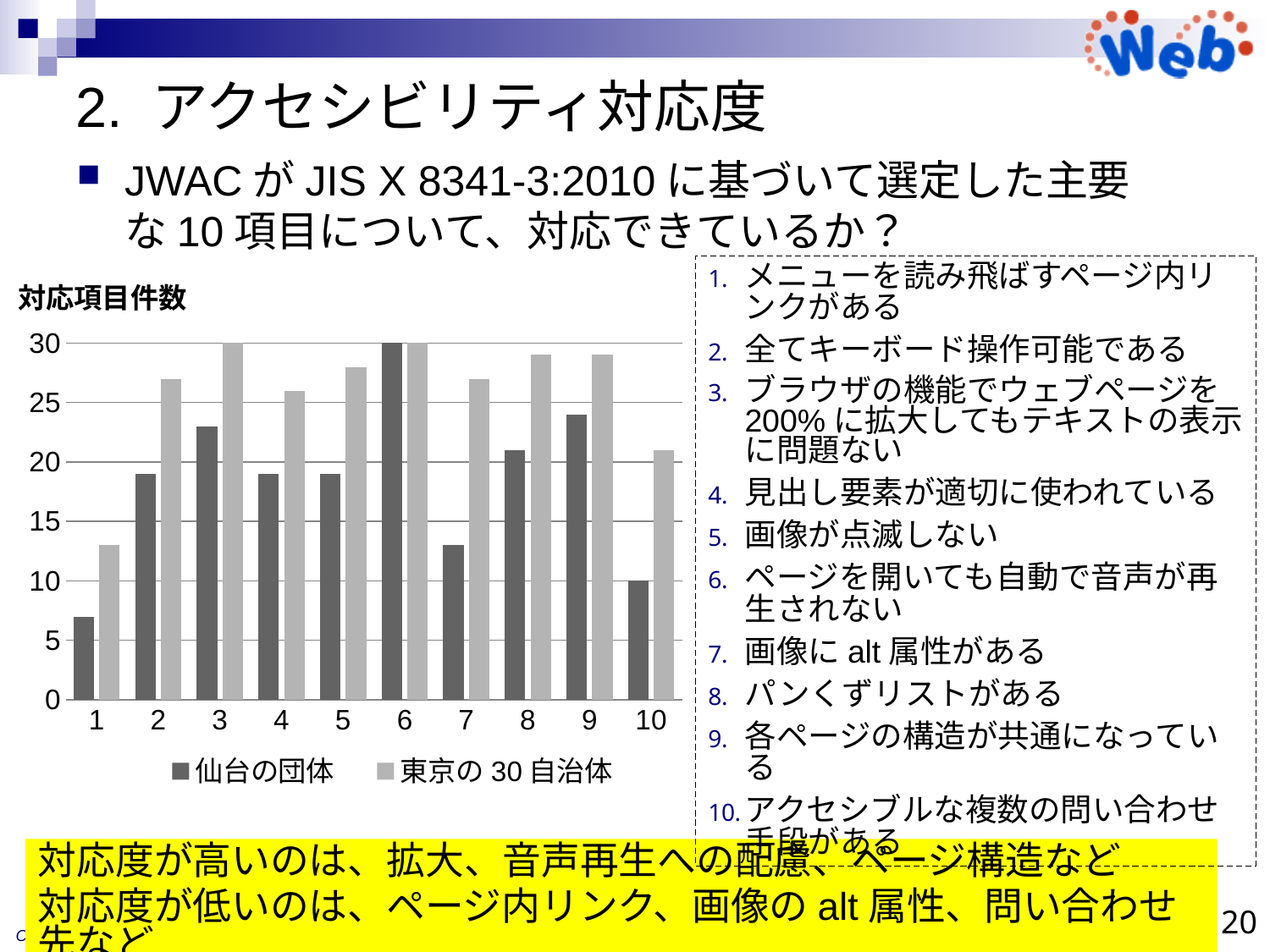
What is the value for 仙台の団体 at category 6? 30 How many categories are shown on the x axis of the chart? 10 Which category has the lowest value for 仙台の団体? 1 Which category has the lowest value for 東京の30自治体? 1 What is the title of the chart? 対応項目件数 At category 7, which series has the larger value, 仙台の団体 or 東京の30自治体? 東京の30自治体 Is the value for 仙台の団体 at category 1 greater or less than 10? less How many series does the chart legend list? 2 What is the value for 仙台の団体 at category 10? 10 What is the value for 東京の30自治体 at category 3? 30 Which category has the highest value for 仙台の団体? 6 What kind of chart is shown on the slide? bar chart